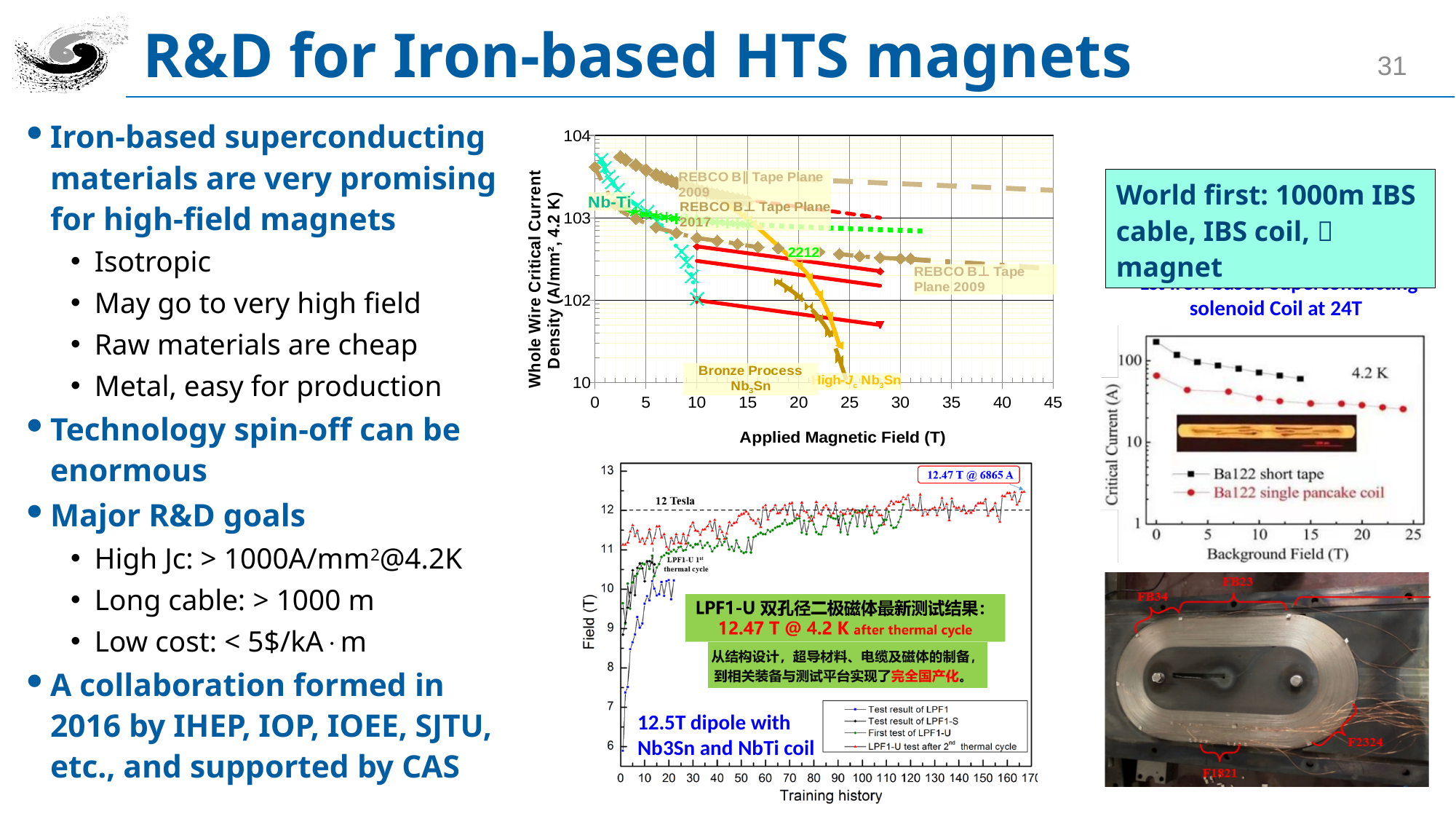
What kind of chart is the bottom-center chart of Field (T) versus Training history? line chart In the right-hand chart of Critical Current versus Background Field, how many series does the legend list? 2 In the bottom-center chart, how many series does the legend list? 4 In the right-hand chart of Critical Current versus Background Field, does the critical current of the Ba122 single pancake coil rise or fall as the background field increases? fall In the right-hand chart of Critical Current versus Background Field, is the critical current of the Ba122 single pancake coil at 0 T greater or less than 100? less In the right-hand chart of Critical Current versus Background Field, is the critical current of the Ba122 short tape at 0 T greater or less than 100? greater In the right-hand chart of Critical Current versus Background Field, which series has the higher critical current at 0 T: Ba122 short tape or Ba122 single pancake coil? Ba122 short tape In the bottom-center chart, what peak field value is annotated in the top-right corner? 12.47 T @ 6865 A In the top-center chart, what is the label of the x axis? Applied Magnetic Field (T) In the bottom-center chart, what field level does the horizontal dashed line mark? 12 Tesla In the top-center chart, what is the highest value shown on the x axis? 45 In the bottom-center chart, what is the label of the x axis? Training history